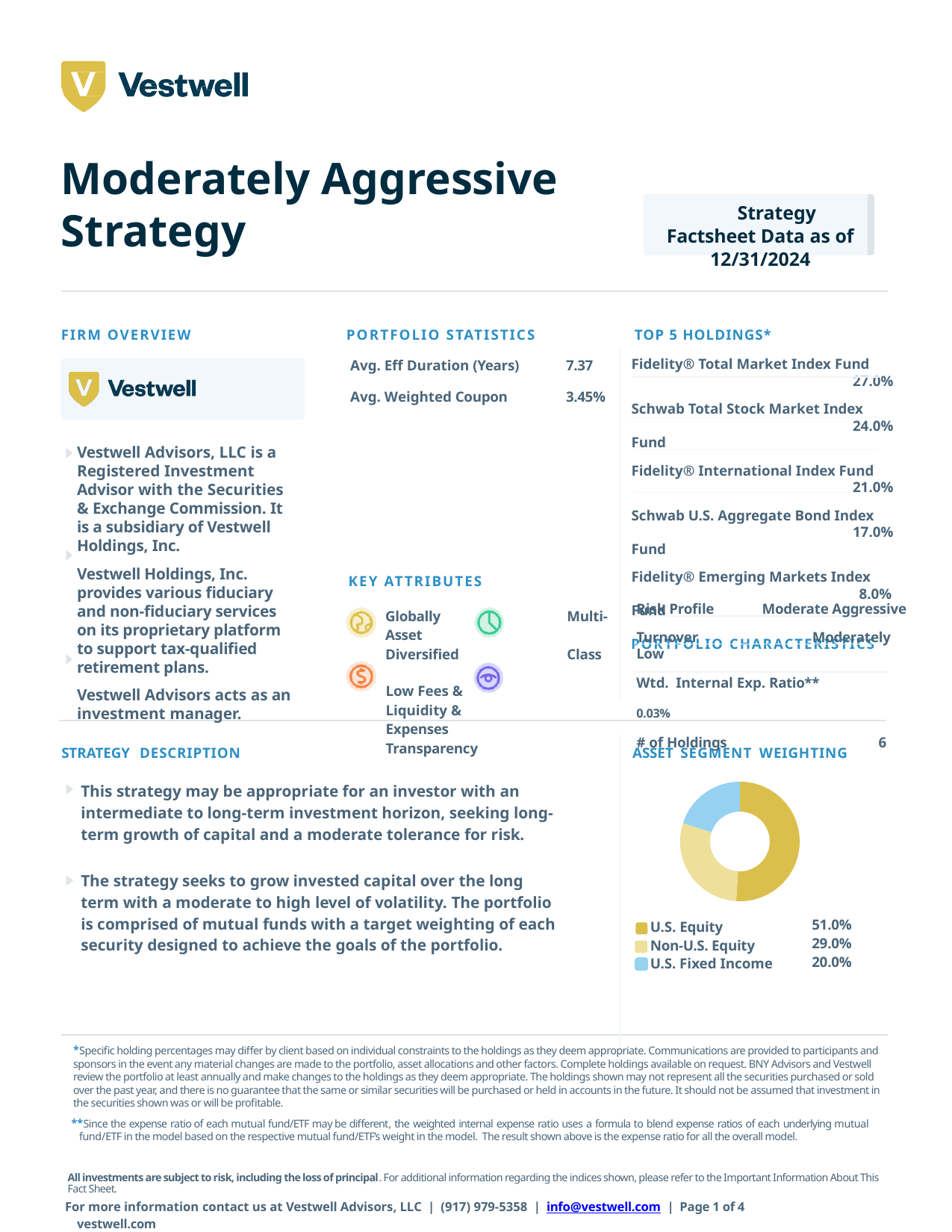
In the Asset Segment Weighting chart, what is the weighting for U.S. Equity? 51.0% In the Asset Segment Weighting chart, what is the weighting for Non-U.S. Equity? 29.0% Which asset segment has the largest weighting in the Asset Segment Weighting chart? U.S. Equity What kind of chart is shown under Asset Segment Weighting? Pie chart (donut) Which asset segment has the smallest weighting in the Asset Segment Weighting chart? U.S. Fixed Income How many asset segments are shown in the Asset Segment Weighting chart? 3 In the Asset Segment Weighting chart, what is the difference between the U.S. Equity and Non-U.S. Equity weightings? 22.0% In the Asset Segment Weighting chart, what colour represents U.S. Fixed Income? Light blue In the Asset Segment Weighting chart, which is larger: Non-U.S. Equity or U.S. Fixed Income? Non-U.S. Equity In the Asset Segment Weighting chart, what is the weighting for U.S. Fixed Income? 20.0% In the Asset Segment Weighting chart, is the U.S. Equity weighting greater or less than 50%? greater What is the title of the chart on the slide? Asset Segment Weighting